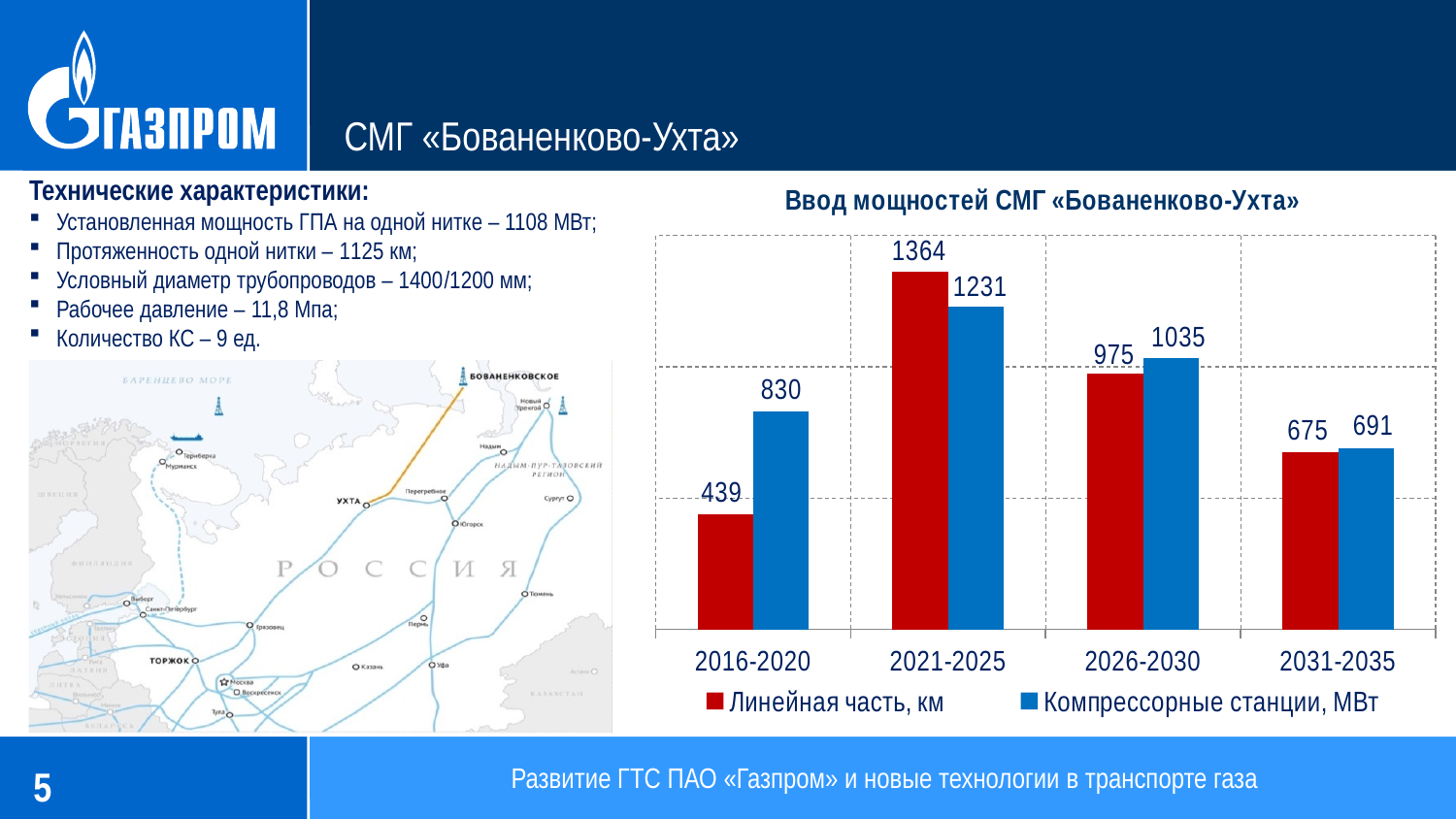
In which period is «Линейная часть, км» highest? 2021-2025 What is the value of «Линейная часть, км» for 2016-2020? 439 What is the title of the chart? Ввод мощностей СМГ «Бованенково-Ухта» Which is larger in 2021-2025: «Линейная часть, км» or «Компрессорные станции, МВт»? Линейная часть, км What is the value of «Линейная часть, км» for 2026-2030? 975 What is the difference between «Линейная часть, км» and «Компрессорные станции, МВт» in 2016-2020? 391 How many series does the legend list? 2 In which period is «Компрессорные станции, МВт» lowest? 2031-2035 How many periods are shown on the x axis? 4 What is the value of «Компрессорные станции, МВт» for 2021-2025? 1231 What kind of chart is shown on the slide? Bar chart What is the value of «Компрессорные станции, МВт» for 2031-2035? 691